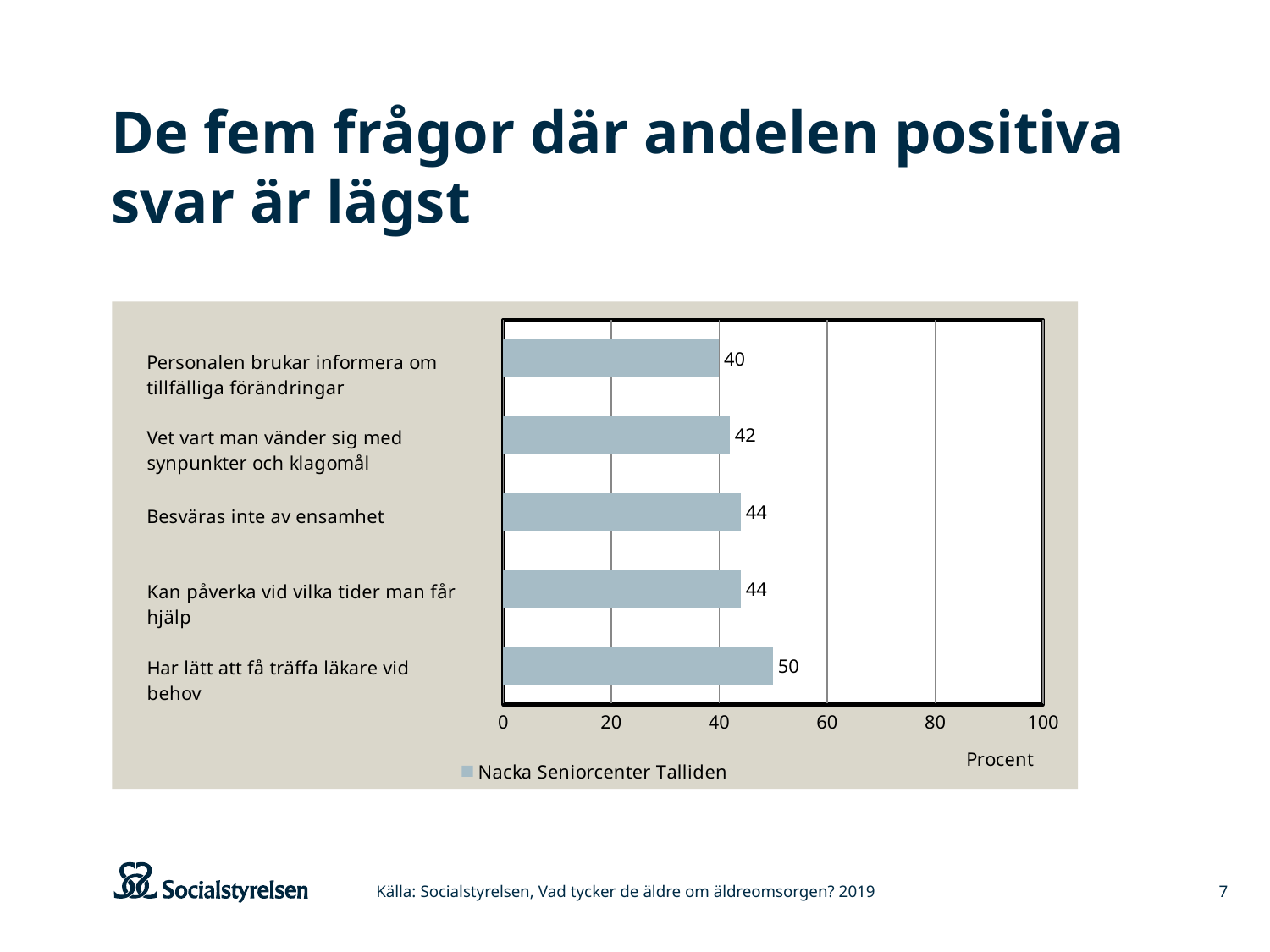
Which category has the highest value? Har lätt att få träffa läkare vid behov What is the value for "Vet vart man vänder sig med synpunkter och klagomål"? 42 Which is larger, the value for "Vet vart man vänder sig med synpunkter och klagomål" or the value for "Kan påverka vid vilka tider man får hjälp"? Kan påverka vid vilka tider man får hjälp What series does the legend list? Nacka Seniorcenter Talliden Which category has the lowest value? Personalen brukar informera om tillfälliga förändringar What is the difference between the values for "Har lätt att få träffa läkare vid behov" and "Personalen brukar informera om tillfälliga förändringar"? 10 How many categories are shown in the chart? 5 What kind of chart is shown on the slide? bar chart Is the value for "Har lätt att få träffa läkare vid behov" greater or less than 60? less What is the value for "Personalen brukar informera om tillfälliga förändringar"? 40 What is the value for "Har lätt att få träffa läkare vid behov"? 50 What is the value for "Besväras inte av ensamhet"? 44